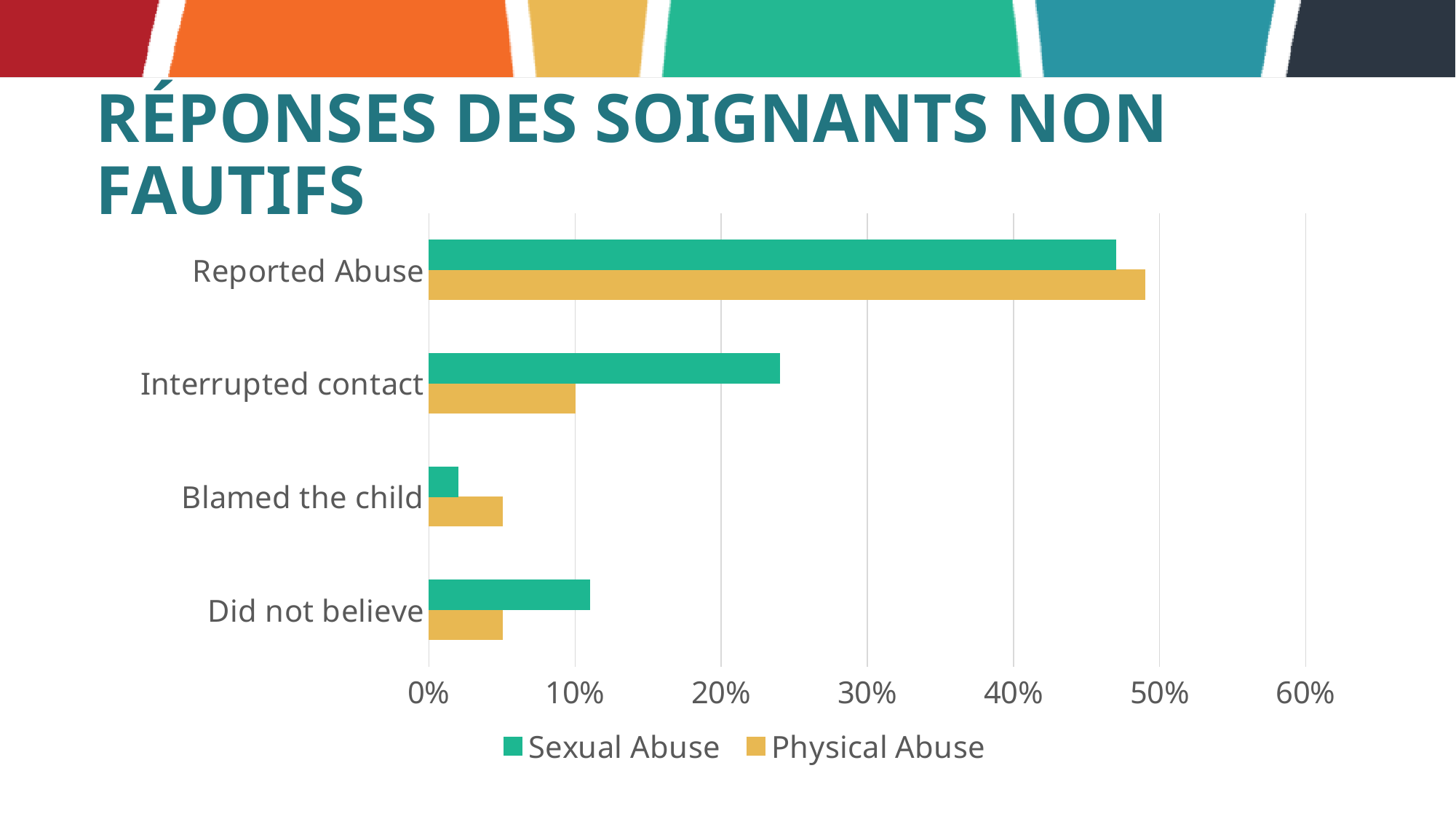
Which category has the lowest value for Sexual Abuse? Blamed the child Which category has the highest value for Sexual Abuse? Reported Abuse Is the Sexual Abuse value for Reported Abuse greater or less than 40%? greater Which category has the highest value for Physical Abuse? Reported Abuse Is the Sexual Abuse value for Interrupted contact greater or less than 20%? greater Which colour represents the Physical Abuse series in the legend? gold For Blamed the child, which series has the larger value, Sexual Abuse or Physical Abuse? Physical Abuse How many categories are shown on the chart? 4 What kind of chart is shown on the slide? bar chart Is the Physical Abuse value for Blamed the child greater or less than 10%? less For Interrupted contact, which series has the larger value, Sexual Abuse or Physical Abuse? Sexual Abuse How many series does the legend list? 2